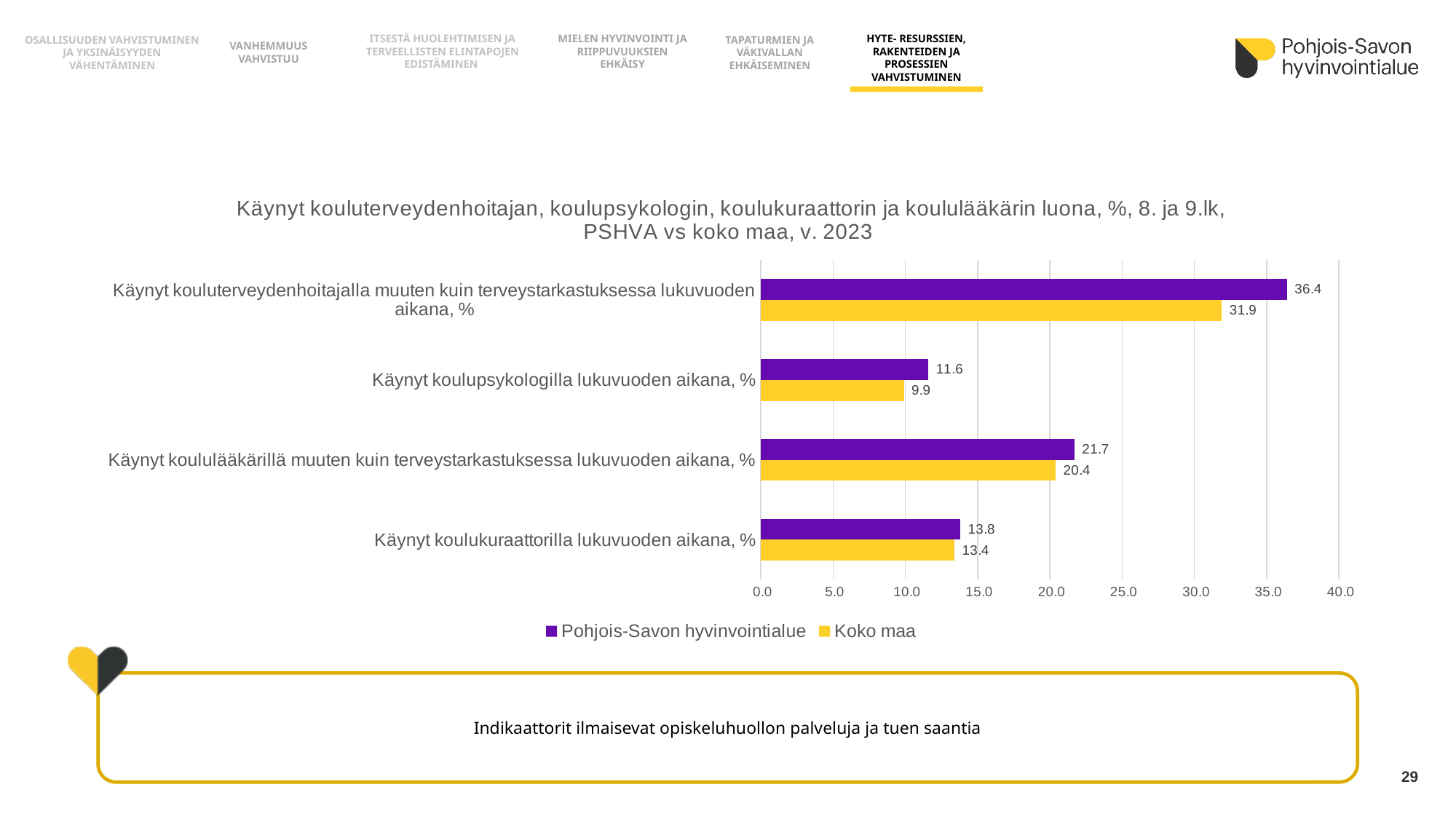
What is the value for Pohjois-Savon hyvinvointialue for 'Käynyt koulukuraattorilla lukuvuoden aikana, %'? 13.8 What is the value for Koko maa for 'Käynyt koululääkärillä muuten kuin terveystarkastuksessa lukuvuoden aikana, %'? 20.4 Is the Koko maa value for 'Käynyt kouluterveydenhoitajalla muuten kuin terveystarkastuksessa lukuvuoden aikana, %' greater or less than 30.0? greater Which is larger for 'Käynyt koululääkärillä muuten kuin terveystarkastuksessa lukuvuoden aikana, %': Pohjois-Savon hyvinvointialue or Koko maa? Pohjois-Savon hyvinvointialue How many series does the legend list? 2 What is the value for Pohjois-Savon hyvinvointialue for 'Käynyt kouluterveydenhoitajalla muuten kuin terveystarkastuksessa lukuvuoden aikana, %'? 36.4 How many categories are shown on the chart? 4 What is the value for Koko maa for 'Käynyt koulupsykologilla lukuvuoden aikana, %'? 9.9 Which category has the lowest value for Koko maa? Käynyt koulupsykologilla lukuvuoden aikana, % What is the difference between Pohjois-Savon hyvinvointialue and Koko maa for 'Käynyt kouluterveydenhoitajalla muuten kuin terveystarkastuksessa lukuvuoden aikana, %'? 4.5 What kind of chart is shown on the slide? Bar chart Which category has the highest value for Pohjois-Savon hyvinvointialue? Käynyt kouluterveydenhoitajalla muuten kuin terveystarkastuksessa lukuvuoden aikana, %